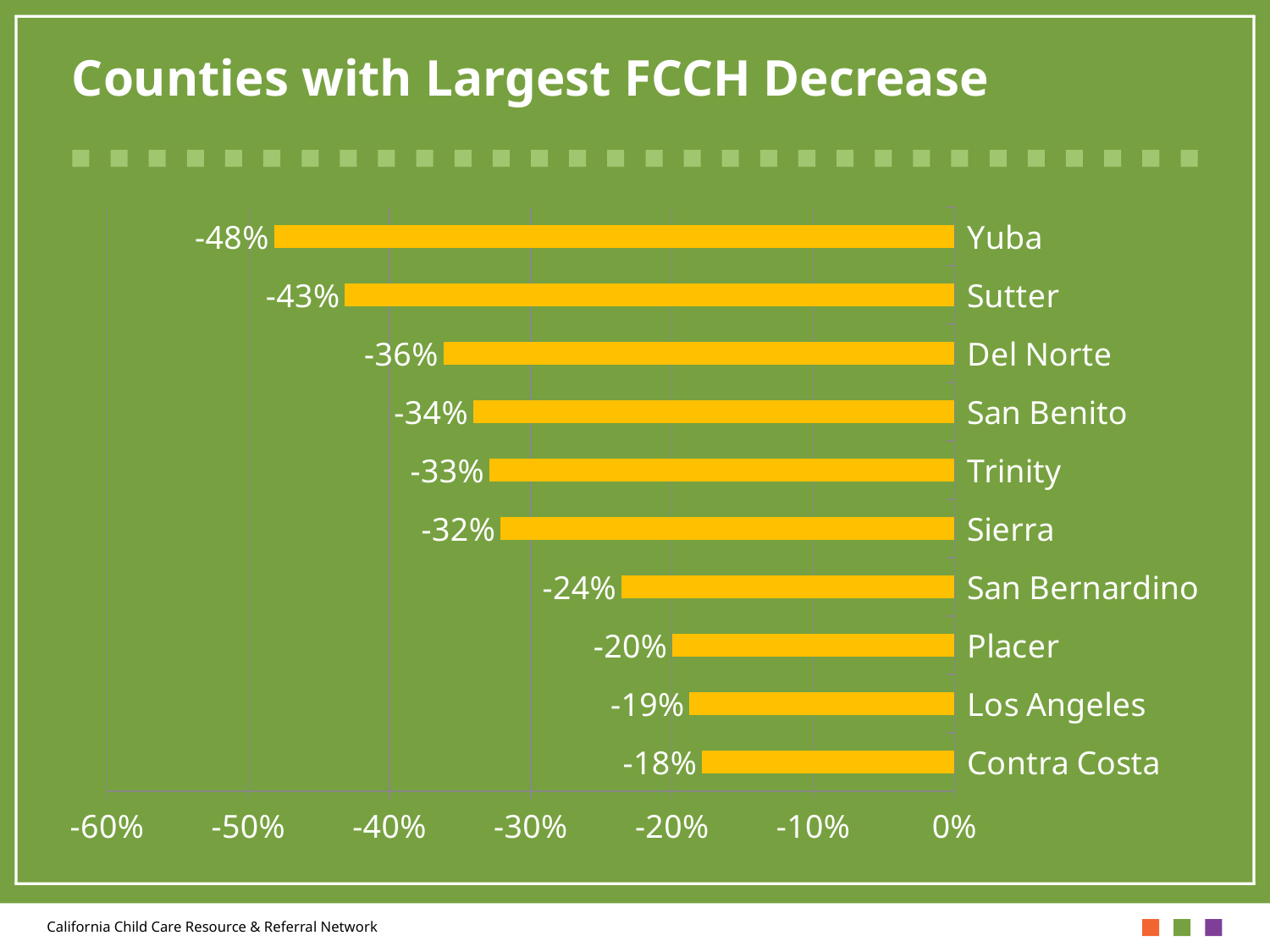
What is the value for Contra Costa? -18% Which county has the smallest decrease (the value closest to 0%)? Contra Costa What kind of chart is shown on the slide? Bar chart What is the value for Yuba? -48% Which county has the largest decrease (the most negative value)? Yuba What is the difference between the values for Del Norte and Placer? 16% What is the difference between the values for Yuba and Sutter? 5% How many counties are shown in the chart? 10 Which county has a larger decrease, Trinity or Los Angeles? Trinity What is the value for San Bernardino? -24% What is the title of the chart? Counties with Largest FCCH Decrease What colour are the bars in the chart? Yellow